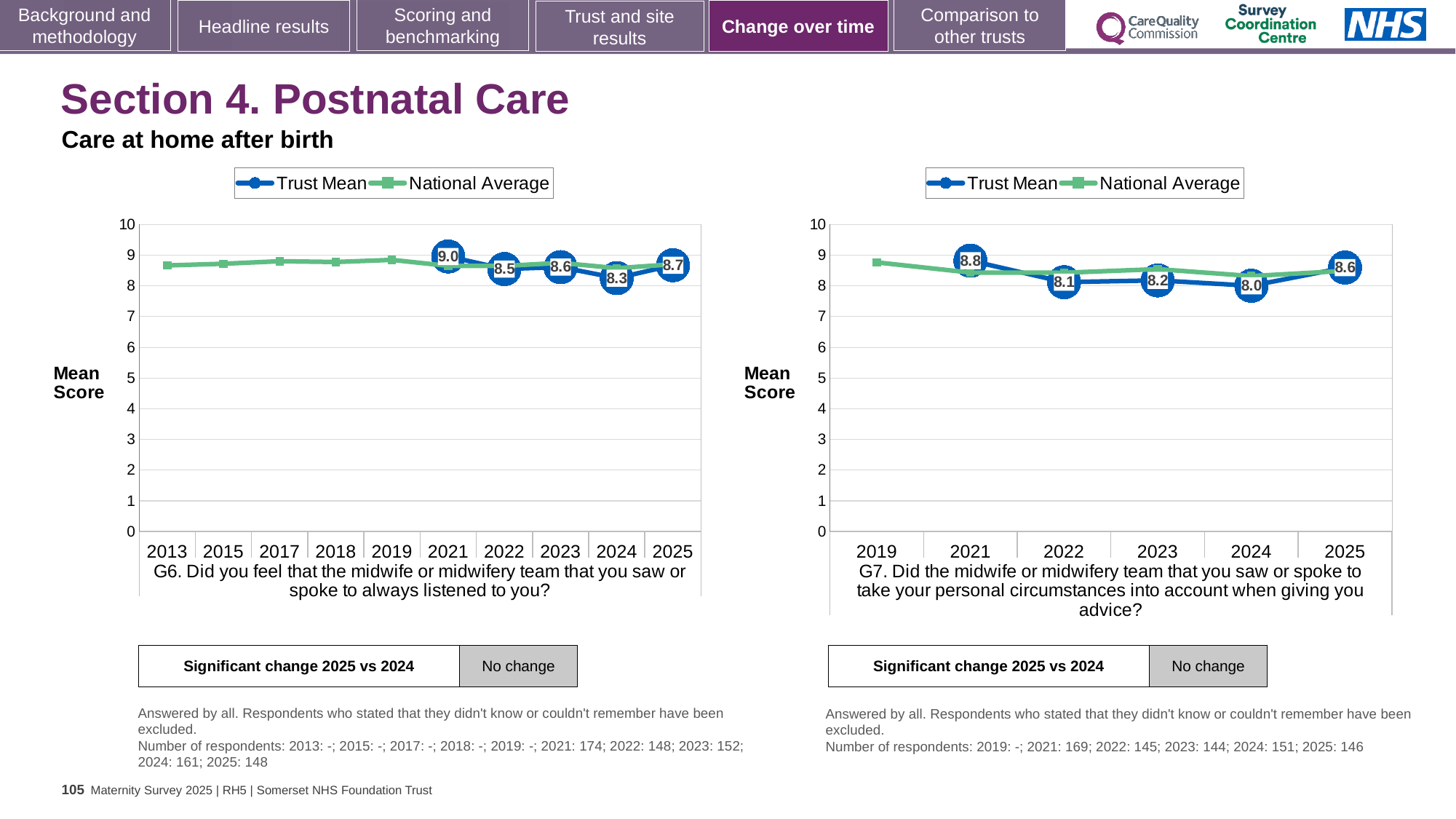
In the left chart (G6), which year has the lowest labelled Trust Mean score? 2024 In the left chart (G6), what is the Trust Mean score for 2025? 8.7 In the right chart (G7), which year has the highest labelled Trust Mean score? 2021 What kind of chart is the left chart (G6)? Line chart In the left chart (G6), what is the Trust Mean score for 2021? 9.0 In the right chart (G7), is the Trust Mean score for 2025 larger than the score for 2022? Yes, 8.6 vs 8.1 How many series does the legend of the right chart (G7) list? 2 In the right chart (G7), is the National Average value for 2019 greater or less than 8? greater In the right chart (G7), what is the difference between the Trust Mean scores for 2025 and 2024? 0.6 In the left chart (G6), how many years are shown on the x axis? 10 In the right chart (G7), what is the Trust Mean score for 2024? 8.0 In the left chart (G6), what is the difference between the Trust Mean scores for 2021 and 2024? 0.7